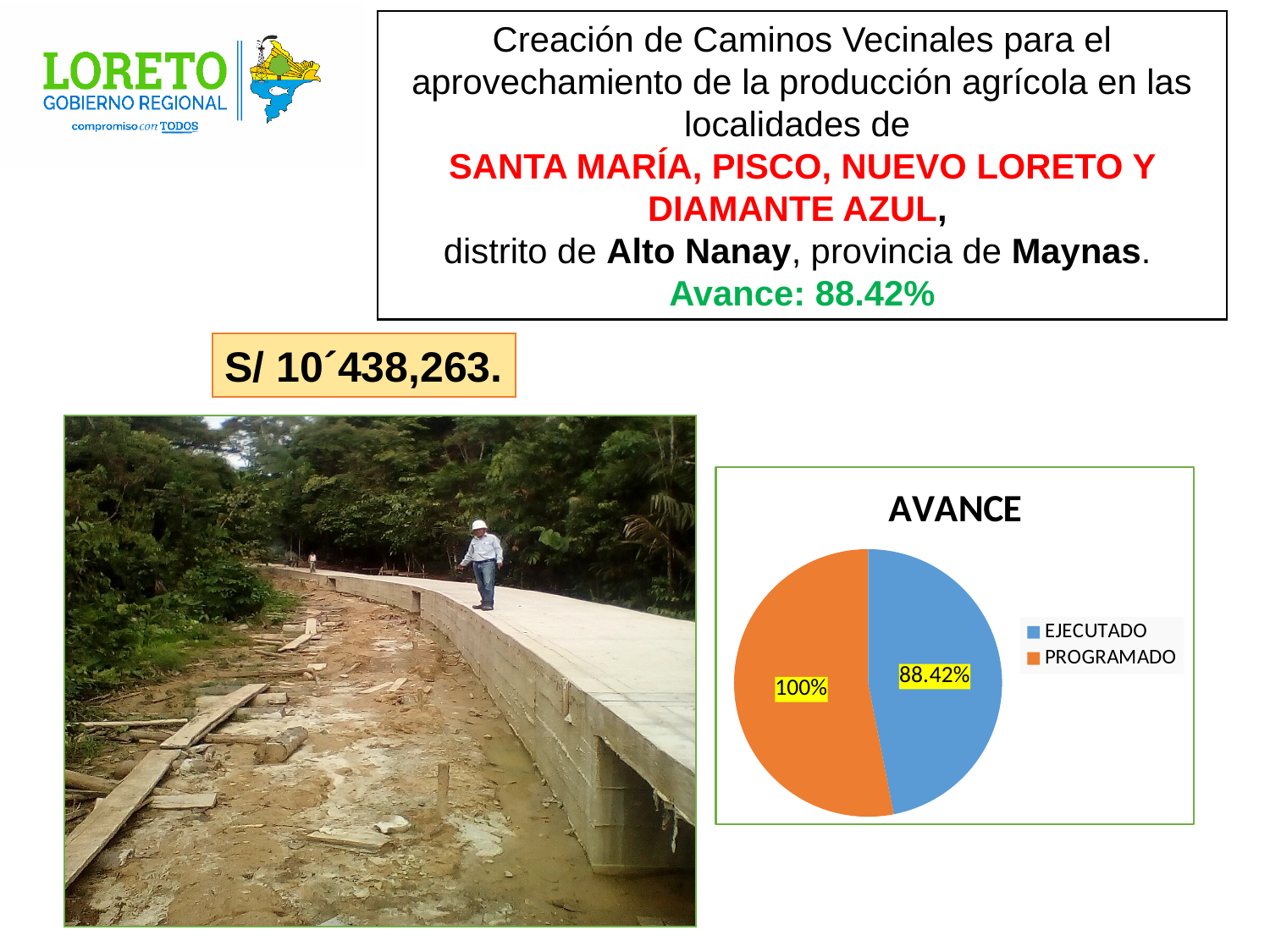
What is the title of the chart? AVANCE What is the difference between the PROGRAMADO value and the EJECUTADO value? 11.58% What kind of chart is shown on the slide? pie chart Which colour represents EJECUTADO in the pie chart? blue How many slices does the pie chart have? 2 What value is shown for EJECUTADO in the pie chart? 88.42% How many entries does the chart legend list? 2 What value is shown for PROGRAMADO in the pie chart? 100% Which category has the smaller value in the pie chart? EJECUTADO Is the value for EJECUTADO larger or smaller than the value for PROGRAMADO? smaller Which category has the larger value in the pie chart? PROGRAMADO